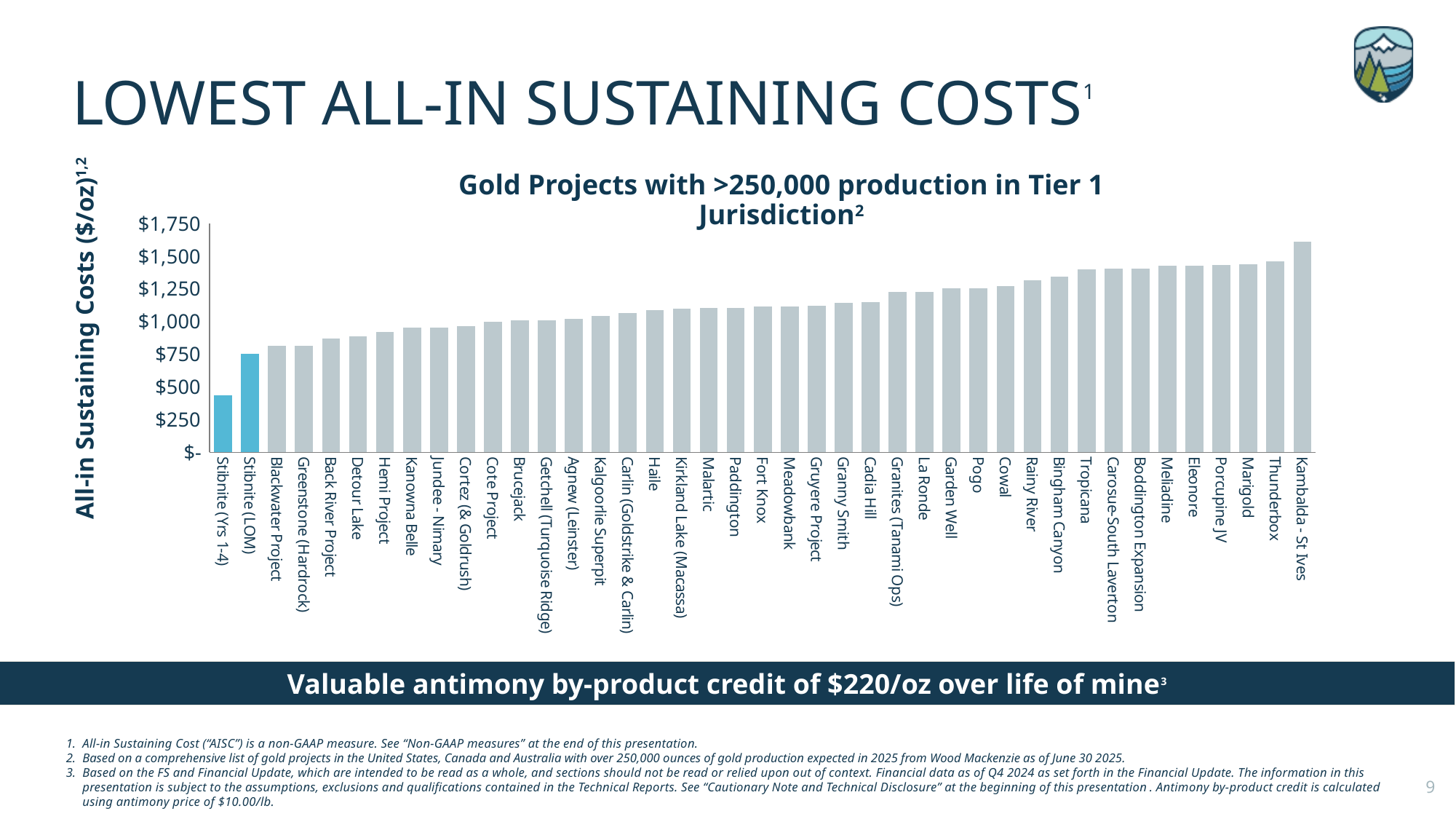
Is the value for Stibnite (LOM) greater or less than $1,000? less Which project has the lowest all-in sustaining cost in the chart? Stibnite (Yrs 1-4) Do the bar values rise or fall moving from left to right along the x axis? Rise Is the value for Stibnite (Yrs 1-4) greater or less than $500? less Which project has the highest all-in sustaining cost in the chart? Kambalda - St Ives Is the value for Haile greater or less than $1,000? greater Which has the higher all-in sustaining cost, Stibnite (LOM) or Thunderbox? Thunderbox What is the title of the chart? Gold Projects with >250,000 production in Tier 1 Jurisdiction What kind of chart is shown on the slide? Bar chart How many projects are plotted in the chart? 41